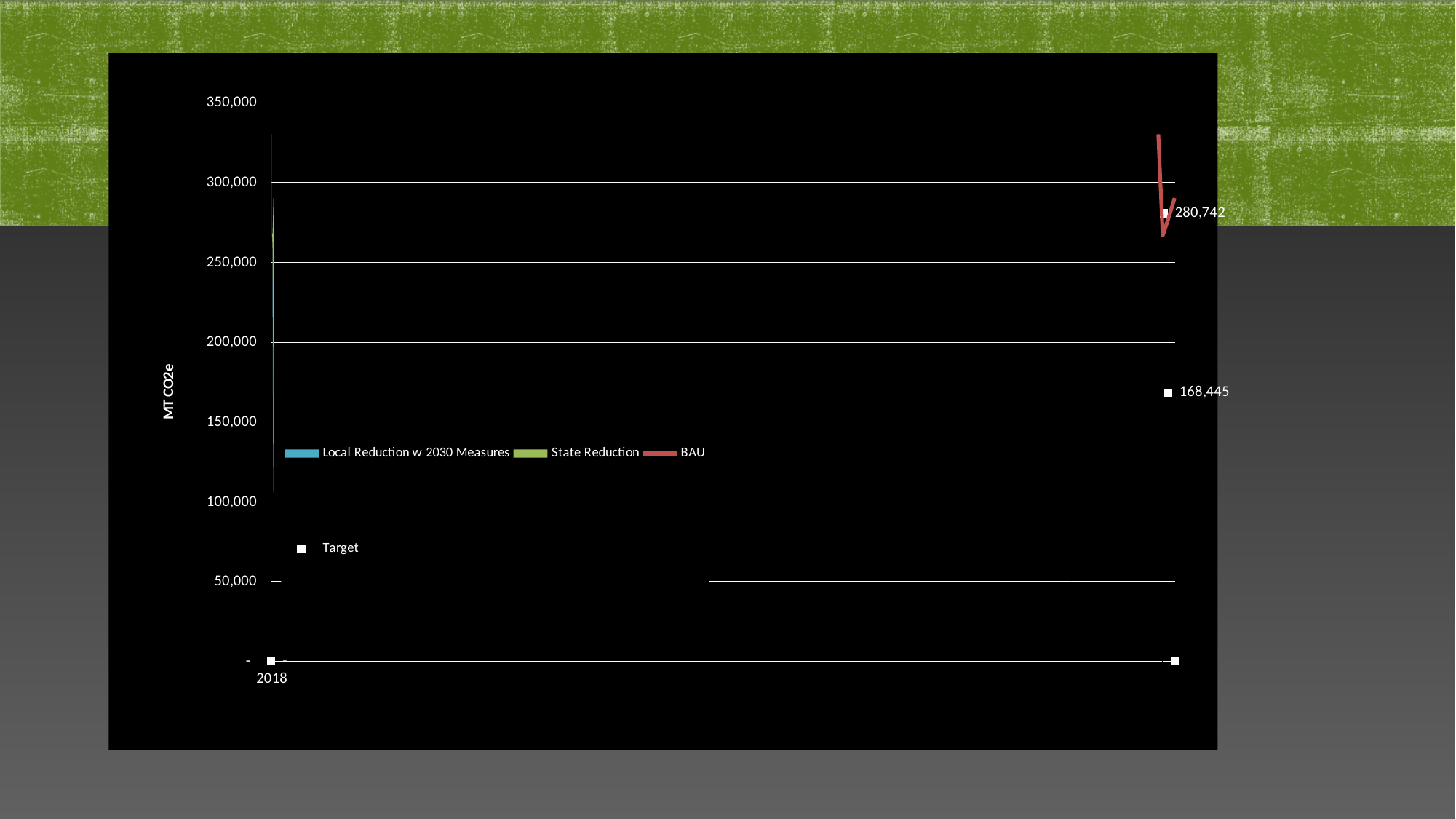
Which legend entry on the chart is shown in red? BAU What is the title of the vertical axis on the chart? MT CO2e What is the lowest data label printed on the chart? 168,445 What is the highest data label printed on the chart? 280,742 Which of the two labelled values on the chart is larger, 280,742 or 168,445? 280,742 Is the data point labelled 168,445 greater or less than 200,000 on the vertical axis? less How many data labels are printed on the chart? 2 What is the maximum value shown on the vertical axis of the chart? 350,000 What is the difference between the two data labels 280,742 and 168,445 on the chart? 112,297 What is the first year label shown on the horizontal axis of the chart? 2018 Is the data point labelled 280,742 greater or less than 250,000 on the vertical axis? greater